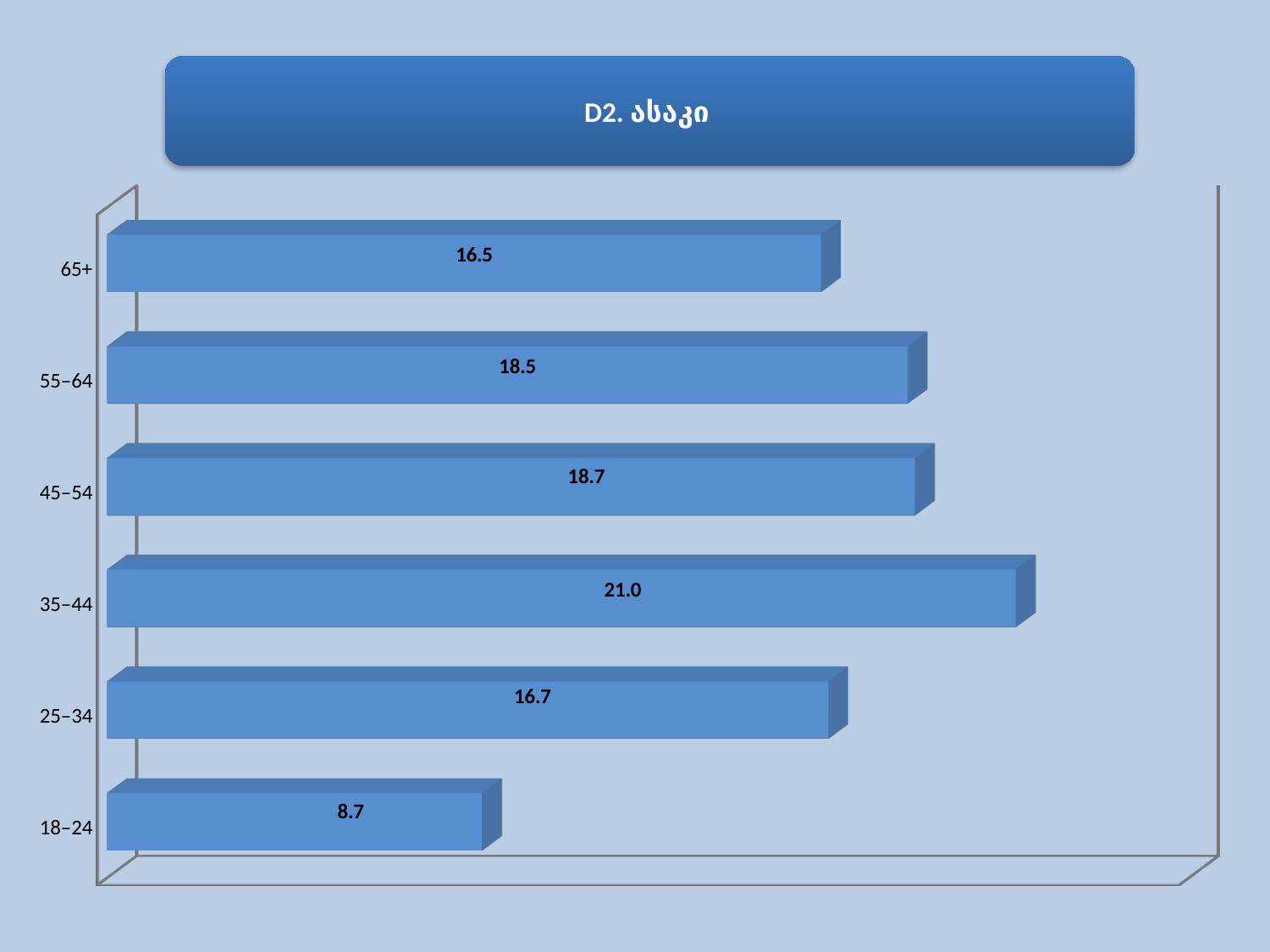
What kind of chart is shown on the slide? Bar chart Which age group has the lowest value? 18–24 What is the difference between the values for 45–54 and 25–34? 2.0 What is the value for the 65+ age group? 16.5 Which age group has the highest value? 35–44 What is the value for the 18–24 age group? 8.7 What is the value for the 35–44 age group? 21.0 What is the title of the chart? D2. ასაკი Which is larger, the value for 35–44 or the value for 25–34? 35–44 How many age groups are shown in the chart? 6 What is the value for the 55–64 age group? 18.5 What is the difference between the values for 35–44 and 18–24? 12.3